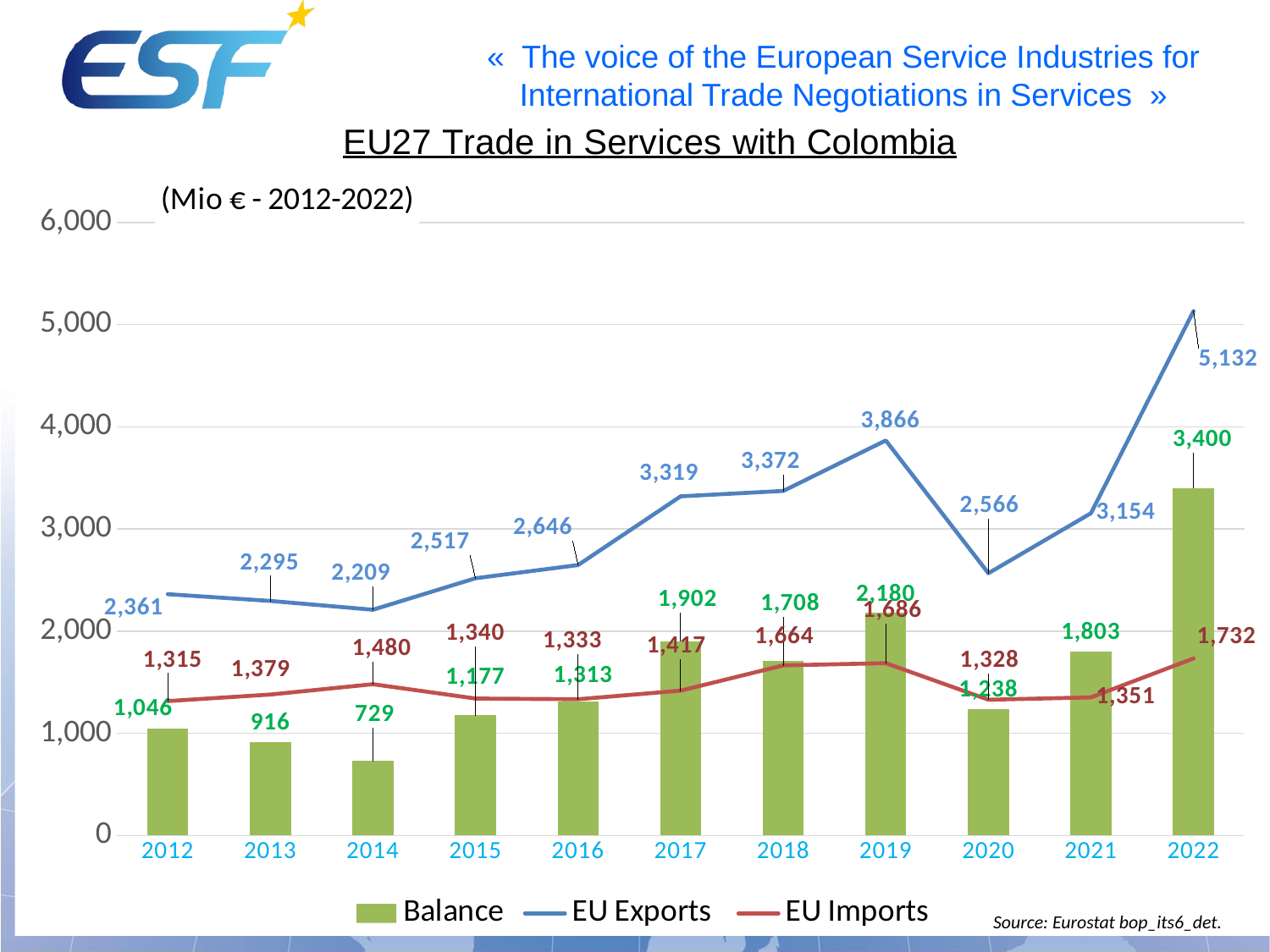
Is the value of EU Exports in 2019 greater or less than 3,000? greater In which year were EU Exports highest? 2022 Which series is shown as bars rather than lines? Balance What was the Balance in 2014? 729 How many series does the legend list? 3 What was the value of EU Imports in 2018? 1,664 How many years are shown on the x axis? 11 Which was larger in 2020: EU Exports or EU Imports? EU Exports What was the value of EU Exports in 2022? 5,132 What is the difference between EU Exports and EU Imports in 2019? 2,180 In which year was the Balance lowest? 2014 Did EU Exports rise or fall from 2021 to 2022? rise